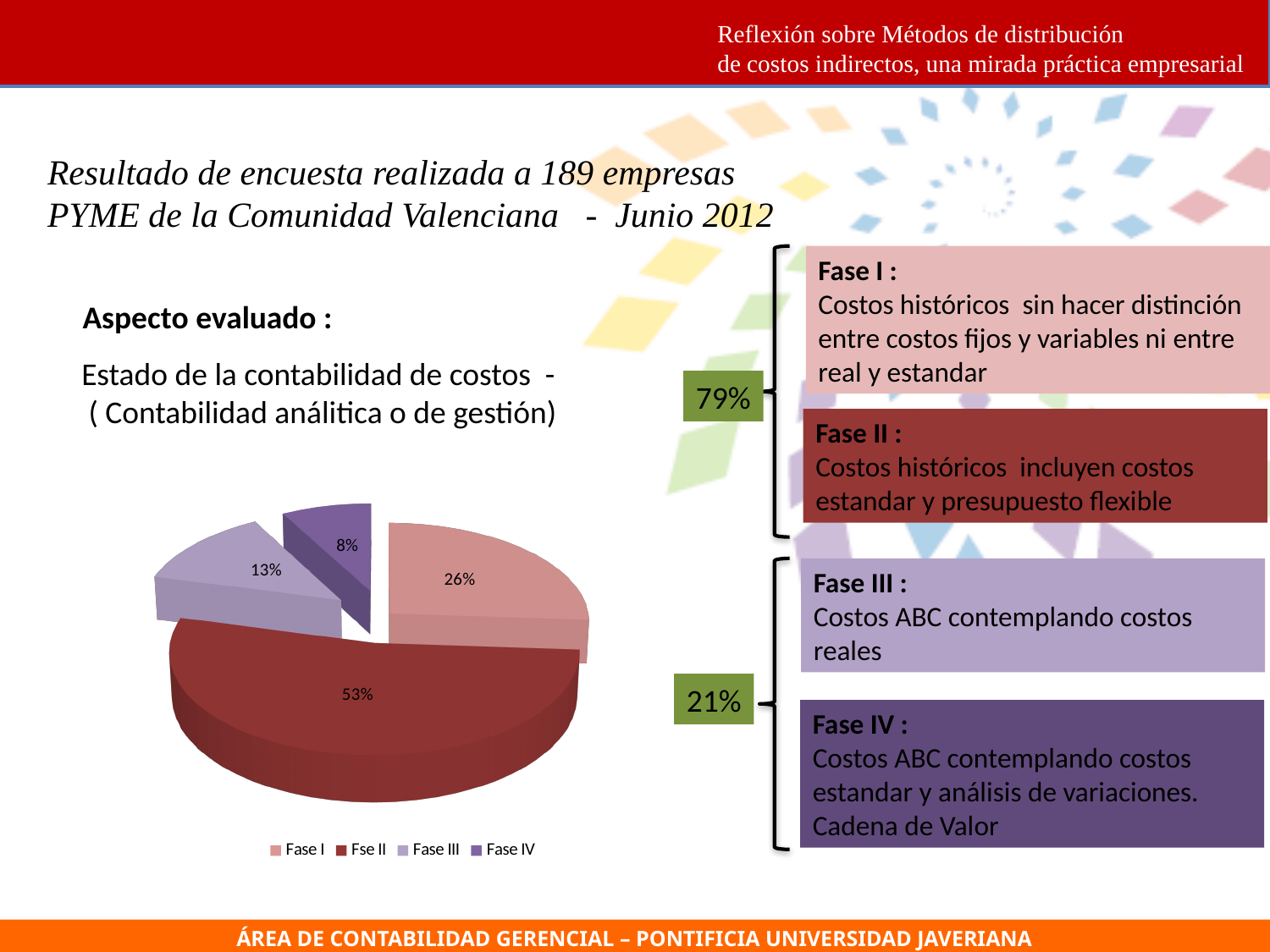
How many entries does the pie chart legend list? 4 What percentage does the Fase III slice of the pie chart represent? 13% Which slice of the pie chart is the largest? Fse II What percentage does the Fase I slice of the pie chart represent? 26% What is the difference in percentage points between the Fse II slice and the Fase I slice? 27 What percentage does the Fse II slice of the pie chart represent? 53% What percentage does the Fase IV slice of the pie chart represent? 8% What type of chart is shown on the slide? pie chart How many slices does the pie chart have? 4 Which slice of the pie chart is the smallest? Fase IV Which is larger in the pie chart, Fase III or Fase IV? Fase III What colour is the Fse II slice in the pie chart? dark red